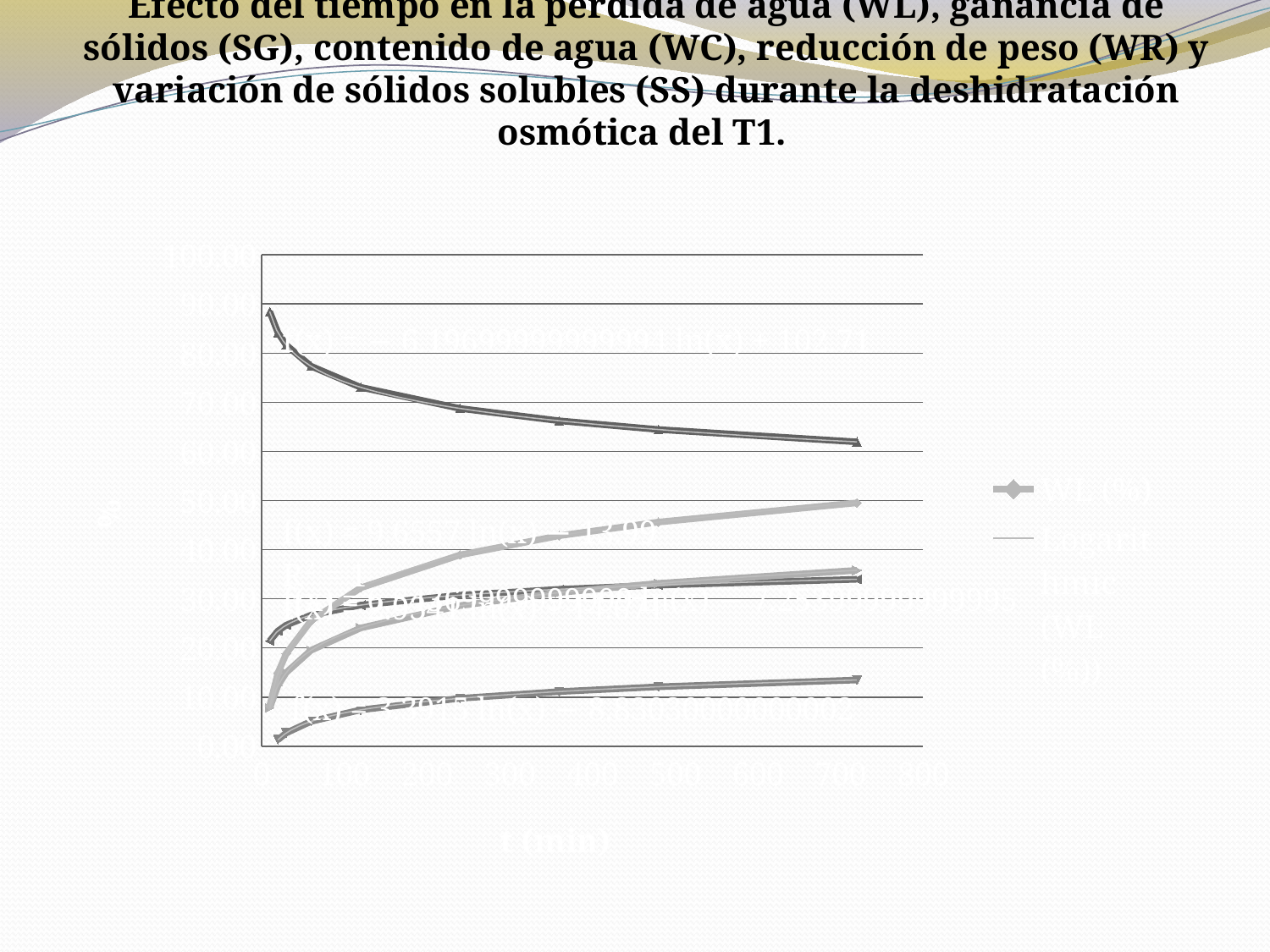
What kind of chart is shown on the slide? line chart Is the starting value of the topmost line (near t = 0) greater or less than 80? greater At the right end of the chart (near t = 700), which is larger: the value of the topmost line or the value of the lowest line? the topmost line Does the topmost line in the chart rise or fall as time increases along the x axis? fall What is the title of the x axis of the chart? t (min) Is the value of the topmost line at about t = 300 greater or less than 60? greater Is the final value of the lowest line (near t = 700) greater or less than 20? less What is the highest value shown on the y axis of the chart? 100.00 Does the lowest line in the chart rise or fall as time increases along the x axis? rise